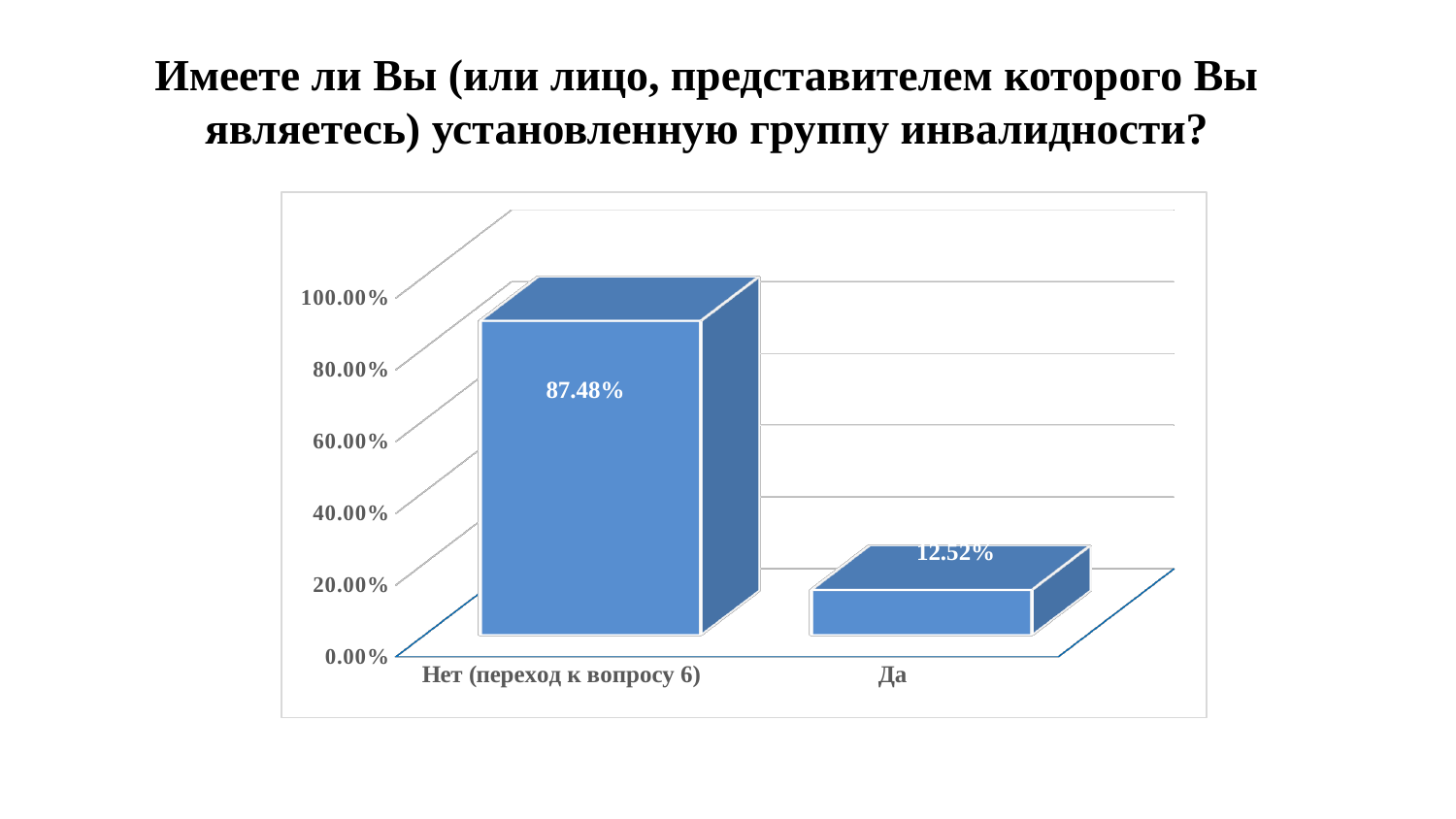
What colour are the bars in the chart? blue Is the value for "Да" greater or less than 20.00%? less What is the difference between the values for "Нет (переход к вопросу 6)" and "Да"? 74.96% What is the value for "Да"? 12.52% Which category has the highest value? Нет (переход к вопросу 6) What is the value for "Нет (переход к вопросу 6)"? 87.48% What kind of chart is shown on the slide? bar chart Which is larger, the value for "Да" or the value for "Нет (переход к вопросу 6)"? Нет (переход к вопросу 6) Which category has the lowest value? Да What is the highest value shown on the vertical axis? 100.00% Is the value for "Нет (переход к вопросу 6)" greater or less than 80.00%? greater How many categories are shown on the chart? 2